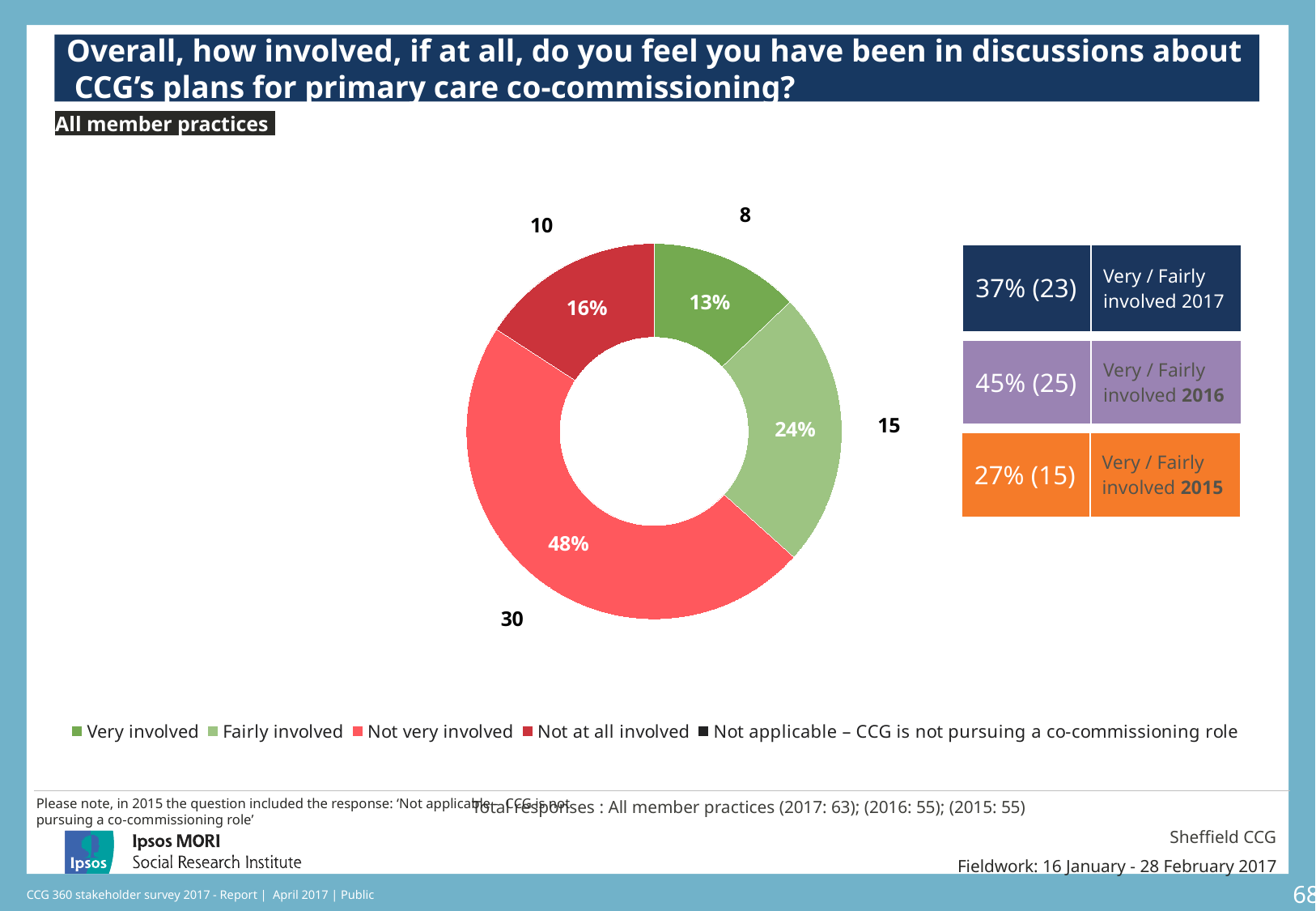
What percentage of respondents said they were 'Not at all involved'? 16% Which is larger: the share for 'Not at all involved' or the share for 'Very involved'? Not at all involved What percentage of respondents said they were 'Very involved'? 13% Which response category shown on the donut chart has the smallest share? Very involved What is the difference in percentage points between 'Not very involved' and 'Fairly involved'? 24 percentage points Which response category has the largest share of the donut chart? Not very involved According to the boxes on the right, what was the combined 'Very / Fairly involved' percentage in 2016? 45% (25) What percentage of respondents said they were 'Fairly involved'? 24% What percentage of respondents said they were 'Not very involved'? 48% How many respondents (count) said they were 'Not very involved'? 30 What type of chart is used on this slide? Donut (pie) chart How many entries does the legend list? 5